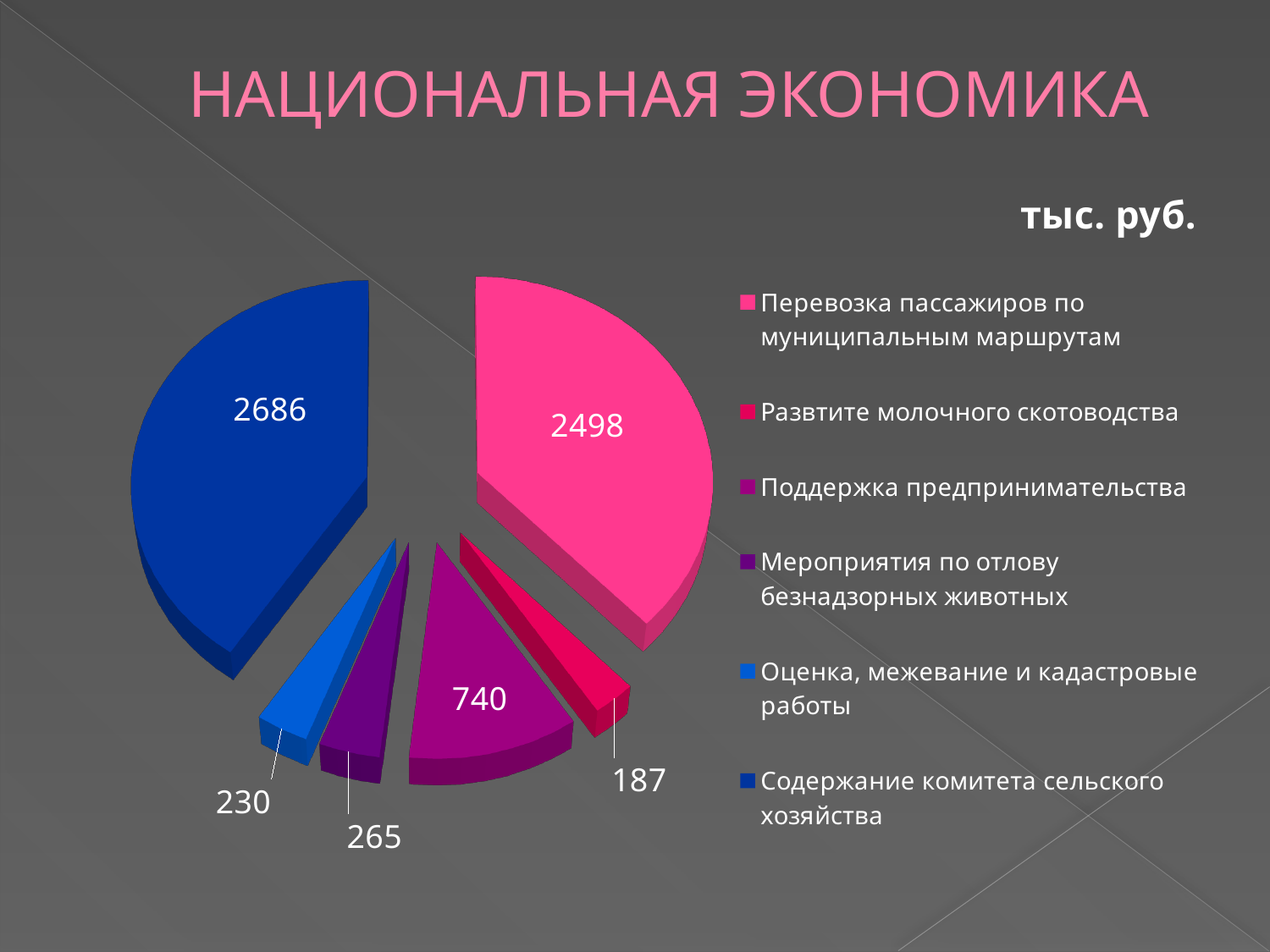
What is the value for Содержание комитета сельского хозяйства? 2686 Which category has the largest value? Содержание комитета сельского хозяйства What is the value for Оценка, межевание и кадастровые работы? 230 Which is larger: the value for Мероприятия по отлову безнадзорных животных or the value for Оценка, межевание и кадастровые работы? Мероприятия по отлову безнадзорных животных What is the difference between the values for Содержание комитета сельского хозяйства and Перевозка пассажиров по муниципальным маршрутам? 188 What is the value for Перевозка пассажиров по муниципальным маршрутам? 2498 Which category has the smallest value? Развтите молочного скотоводства What type of chart is shown on the slide? Pie chart What is the value for Поддержка предпринимательства? 740 How many slices does the pie chart have? 6 What is the value for Развтите молочного скотоводства? 187 In what units are the values on the chart given? тыс. руб.